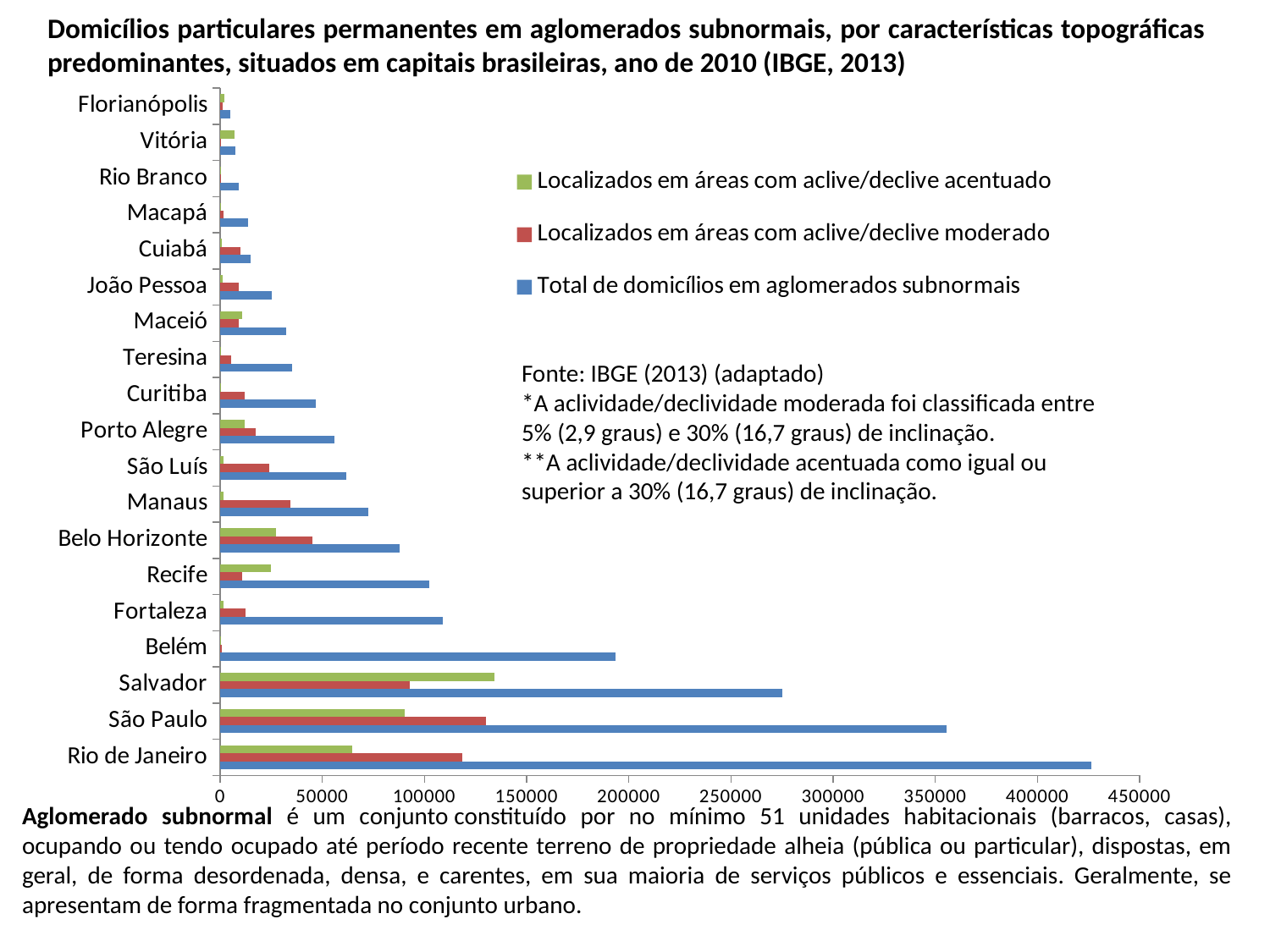
For Salvador, which is larger: the value for 'Localizados em áreas com aclive/declive acentuado' or the value for 'Localizados em áreas com aclive/declive moderado'? Localizados em áreas com aclive/declive acentuado Is the value for 'Localizados em áreas com aclive/declive acentuado' for Salvador greater or less than 100000? greater Which city has the highest value for 'Total de domicílios em aglomerados subnormais'? Rio de Janeiro How many series does the legend list? 3 Is the value for 'Total de domicílios em aglomerados subnormais' for Belém greater or less than 200000? less How many cities are shown on the chart? 19 Which city has the highest value for 'Localizados em áreas com aclive/declive moderado'? São Paulo Which city has the lowest value for 'Total de domicílios em aglomerados subnormais'? Florianópolis Is the value for 'Total de domicílios em aglomerados subnormais' for Rio de Janeiro greater or less than 400000? greater Which series is represented by the blue bars in the legend? Total de domicílios em aglomerados subnormais Which city has the highest value for 'Localizados em áreas com aclive/declive acentuado'? Salvador What kind of chart is shown on the slide? Bar chart